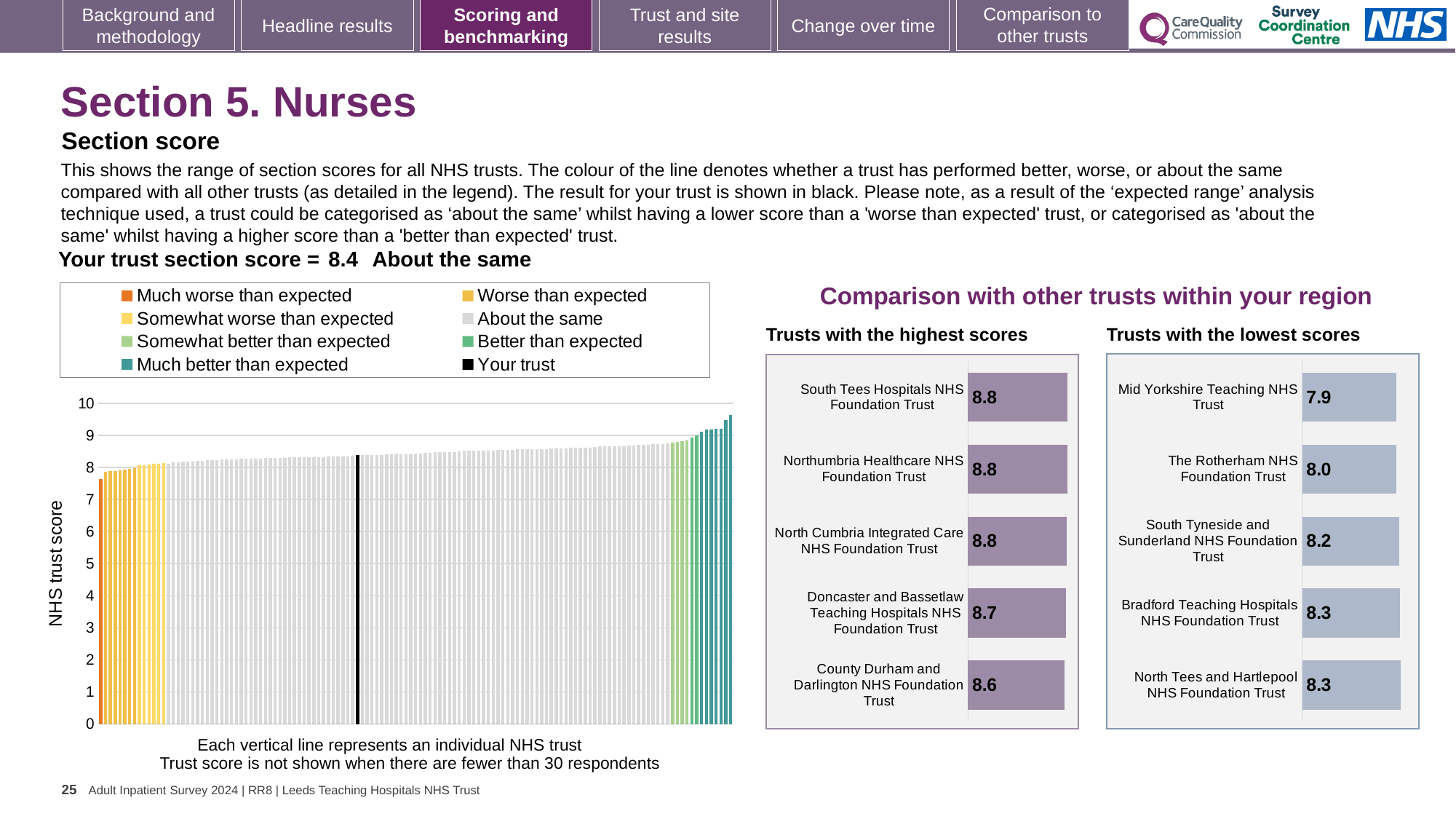
In the main 'NHS trust score' chart, do the trust scores rise or fall from left to right? Rise In the 'Trusts with the lowest scores' chart, what is the score for Mid Yorkshire Teaching NHS Trust? 7.9 In the 'Trusts with the highest scores' chart, what is the score for Doncaster and Bassetlaw Teaching Hospitals NHS Foundation Trust? 8.7 In the 'Trusts with the lowest scores' chart, which has the higher score: The Rotherham NHS Foundation Trust or South Tyneside and Sunderland NHS Foundation Trust? South Tyneside and Sunderland NHS Foundation Trust In the main 'NHS trust score' chart, is the value for the black 'Your trust' bar greater or less than 8? greater What kind of chart is the main chart showing the range of section scores for all NHS trusts? Bar chart In the 'Trusts with the highest scores' chart, what is the score for County Durham and Darlington NHS Foundation Trust? 8.6 In the 'Trusts with the lowest scores' chart, which trust has the lowest score? Mid Yorkshire Teaching NHS Trust In the 'Trusts with the lowest scores' chart, what is the difference between the scores of North Tees and Hartlepool NHS Foundation Trust and Mid Yorkshire Teaching NHS Trust? 0.4 How many entries does the legend of the main 'NHS trust score' chart list? 8 In the 'Trusts with the highest scores' chart, what is the difference between the scores of South Tees Hospitals NHS Foundation Trust and County Durham and Darlington NHS Foundation Trust? 0.2 How many trusts are shown in the 'Trusts with the highest scores' chart? 5